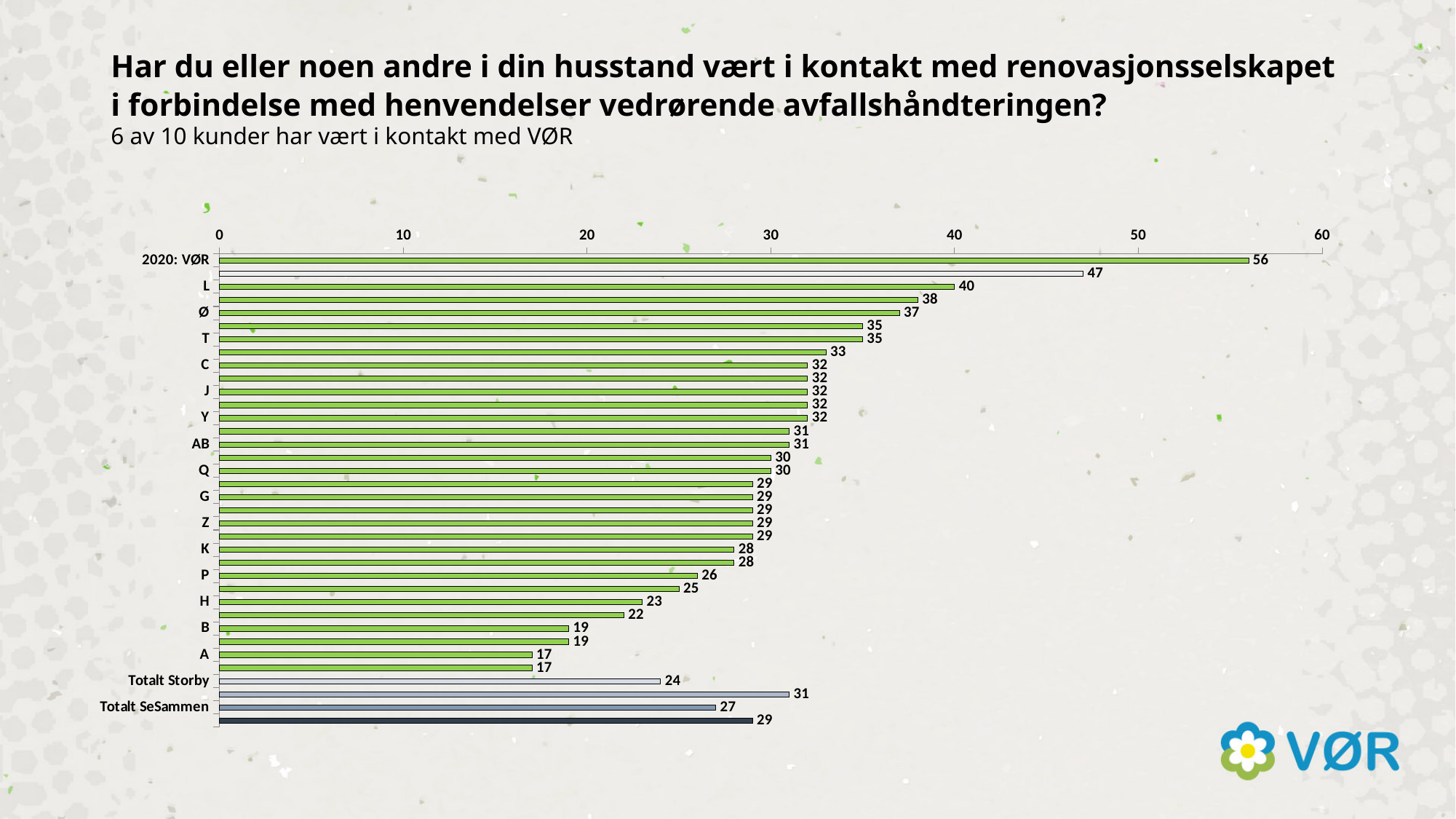
Which category has the highest value? 2020: VØR What is the difference between the values for 2020: VØR and L? 16 What is the value for Totalt SeSammen? 27 What kind of chart is shown on the slide? bar chart What is the value for L? 40 Is the value for H greater or less than 20? greater What is the value for Totalt Storby? 24 What is the value for A? 17 Which is larger, the value for L or the value for Ø? L What is the value for 2020: VØR? 56 What is the value for K? 28 What is the difference between the values for P and H? 3